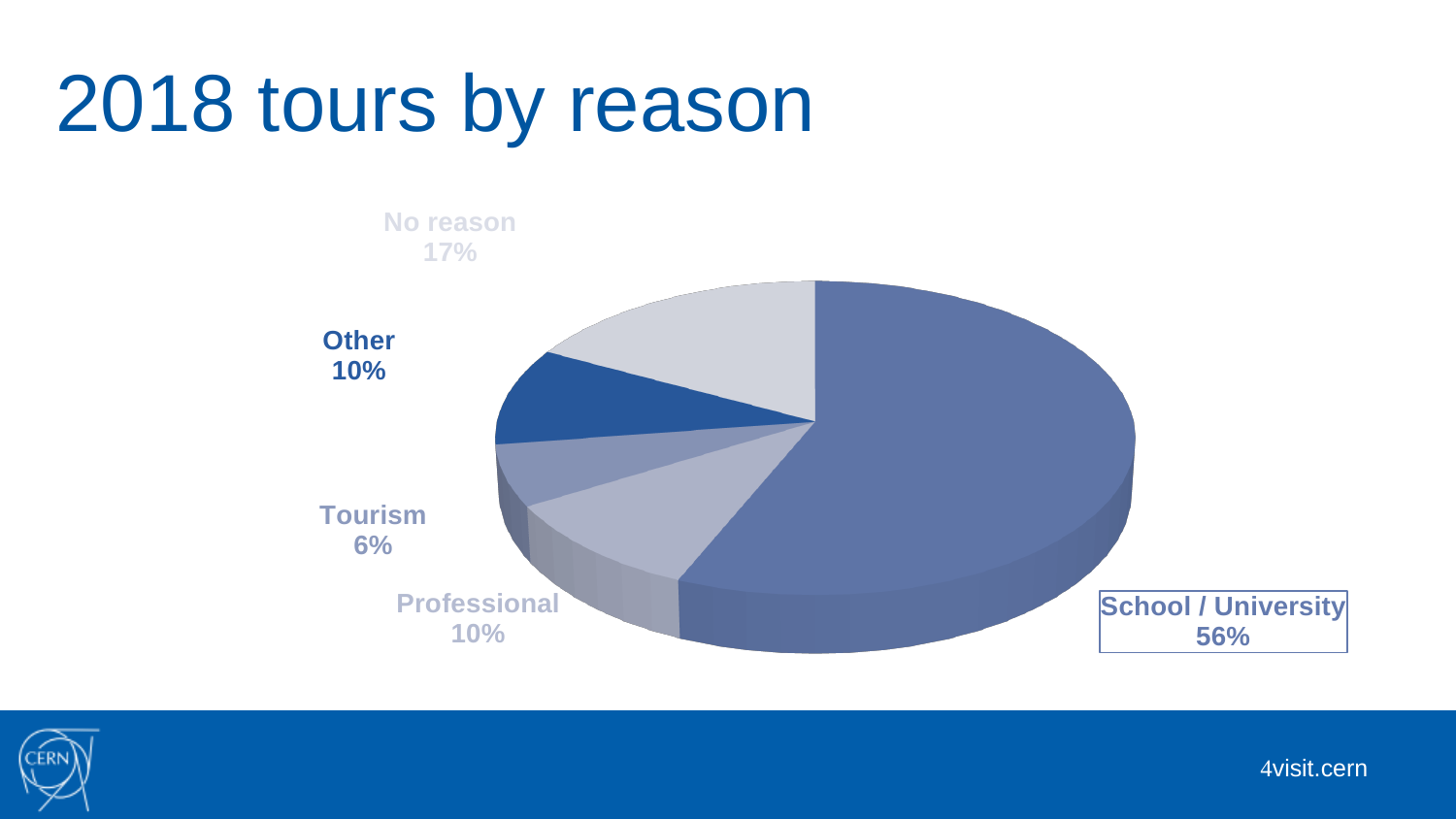
What share of 2018 tours was for School / University? 56% How many reason categories are shown in the pie chart? 5 What is the difference in percentage points between the No reason share and the Tourism share? 11 What percentage of 2018 tours was Professional? 10% What share of 2018 tours was for Tourism? 6% Which reason accounts for the smallest share of 2018 tours? Tourism Which reason accounts for the largest share of 2018 tours? School / University What percentage of 2018 tours had no reason given? 17% What is the title of the chart? 2018 tours by reason How many percentage points larger is the School / University share than the No reason share? 39 Which is larger, the share for No reason or the share for Other? No reason What type of chart is shown on the slide? Pie chart